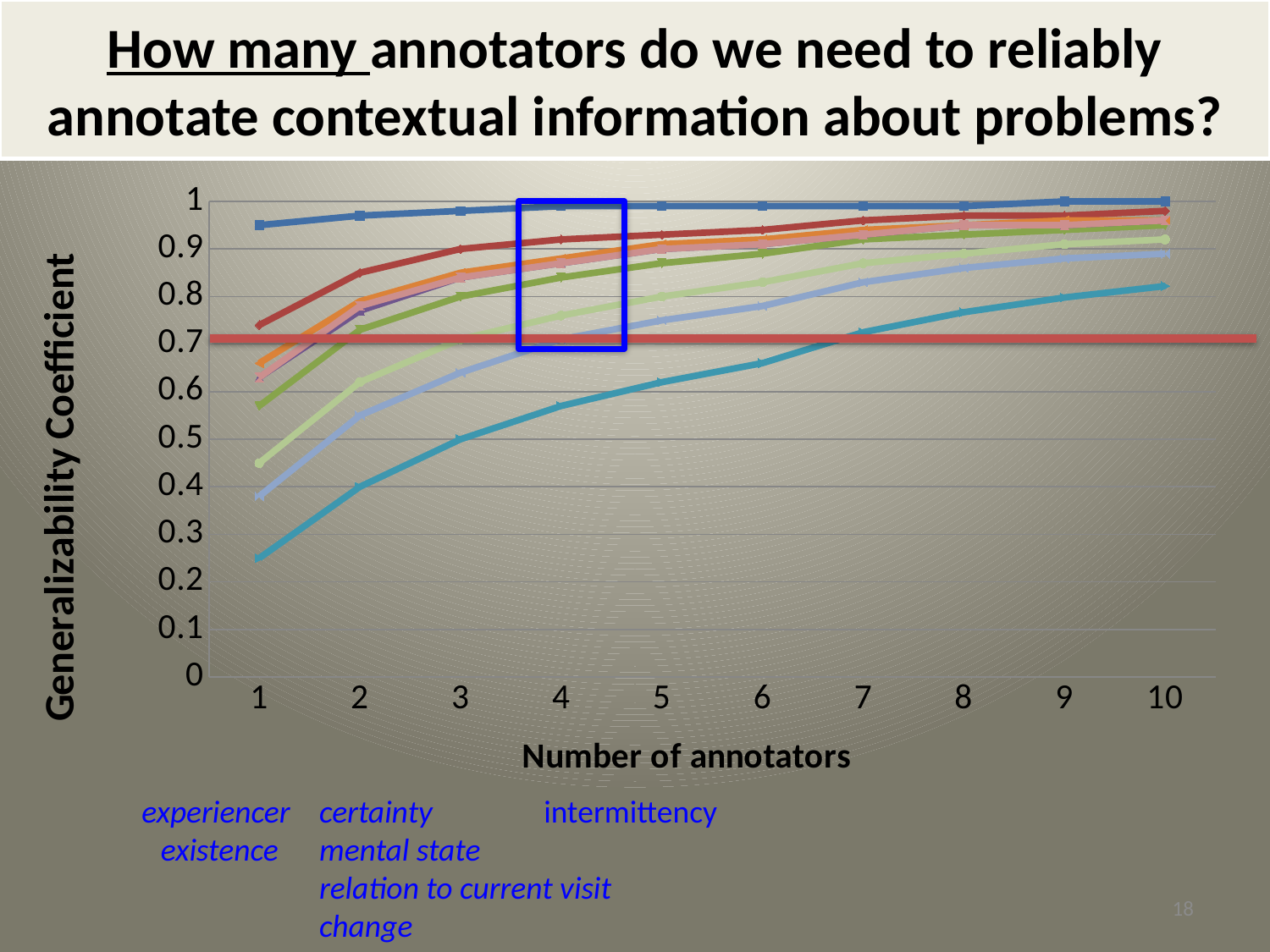
Do the plotted lines rise or fall as the number of annotators increases? rise Is the value of the lowest line at 10 annotators greater or less than 0.7? greater Is the value of the lowest line at 1 annotator greater or less than 0.3? less How many values of the number of annotators are plotted along the x axis? 10 Is the value of the lowest line at 5 annotators greater or less than 0.7? less What is the title of the x axis? Number of annotators What kind of chart is shown on the slide? line chart What is the title of the y axis? Generalizability Coefficient What is the highest tick value shown on the y axis? 1 At which number of annotators do the lines have their lowest values? 1 At which number of annotators does the lowest line reach its highest value? 10